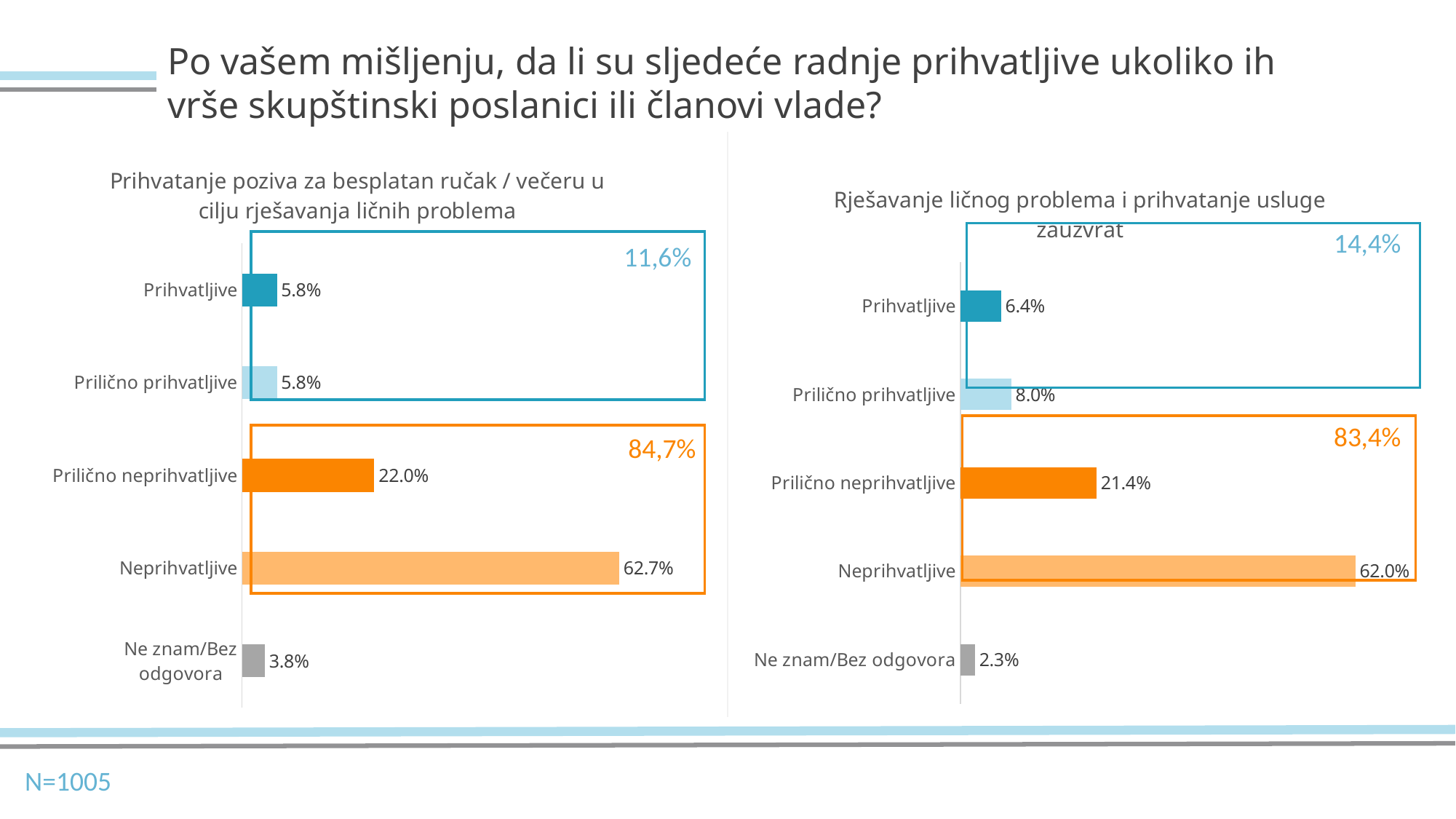
In the right chart (Rješavanje ličnog problema i prihvatanje usluge zauzvrat), what combined percentage is shown in the orange box for the unacceptable categories? 83,4% What type of chart is used on this slide? Bar chart Which is larger: Prilično neprihvatljive in the left chart or Prilično neprihvatljive in the right chart? Left chart (22.0%) In the left chart (Prihvatanje poziva za besplatan ručak / večeru), what combined percentage is shown in the blue box for the acceptable categories? 11,6% In the right chart (Rješavanje ličnog problema i prihvatanje usluge zauzvrat), what is the difference between Prilično prihvatljive and Prihvatljive? 1.6% In the right chart (Rješavanje ličnog problema i prihvatanje usluge zauzvrat), what is the value for Prilično prihvatljive? 8.0% In the left chart (Prihvatanje poziva za besplatan ručak / večeru), what is the value for Neprihvatljive? 62.7% In the right chart (Rješavanje ličnog problema i prihvatanje usluge zauzvrat), which category has the lowest value? Ne znam/Bez odgovora In the left chart (Prihvatanje poziva za besplatan ručak / večeru), which category has the highest value? Neprihvatljive How many categories does the left chart (Prihvatanje poziva za besplatan ručak / večeru) show? 5 In the left chart (Prihvatanje poziva za besplatan ručak / večeru), what is the difference between Neprihvatljive and Prilično neprihvatljive? 40.7% In the right chart (Rješavanje ličnog problema i prihvatanje usluge zauzvrat), what is the value for Ne znam/Bez odgovora? 2.3%